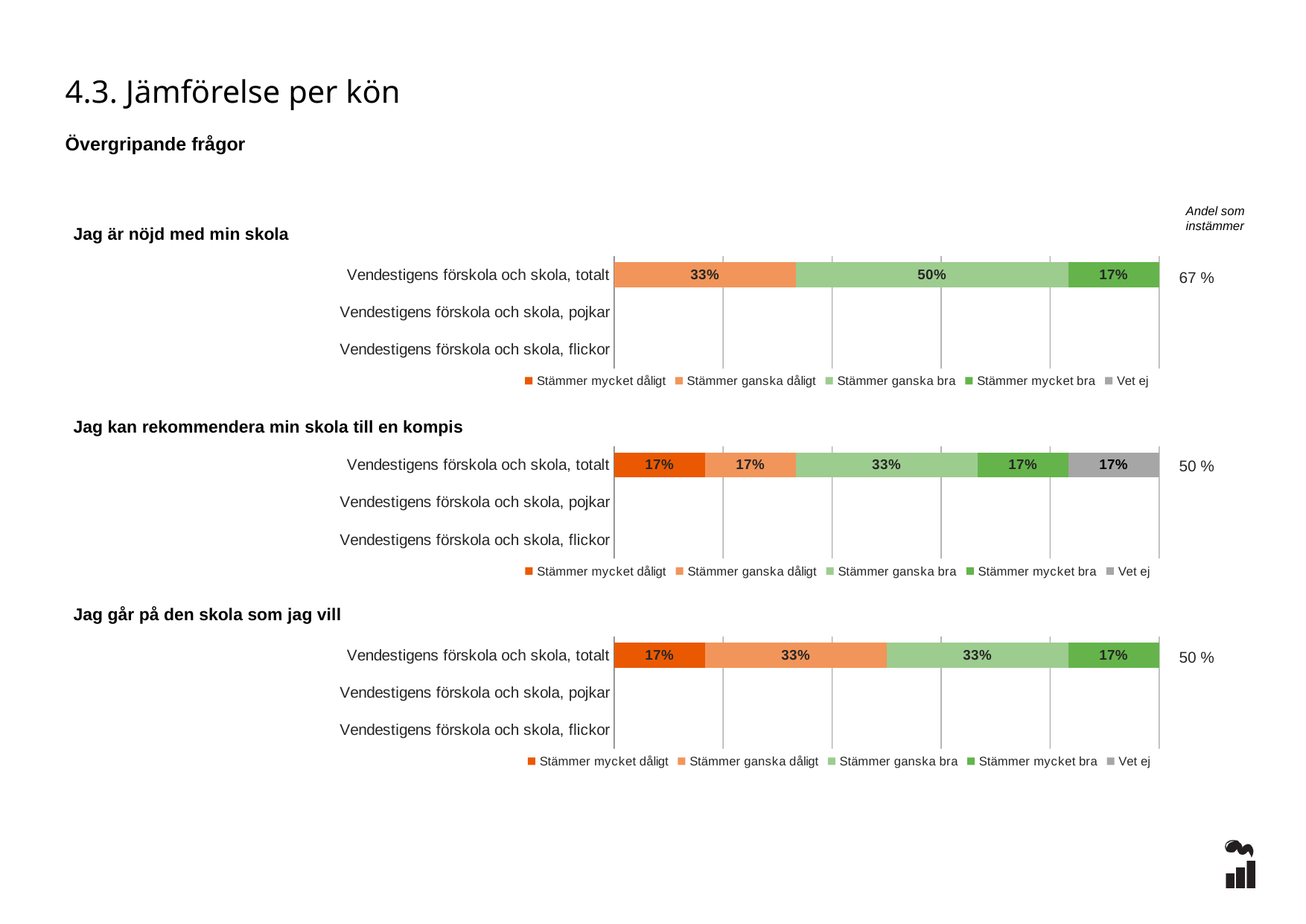
In the chart 'Jag kan rekommendera min skola till en kompis', what is the 'Andel som instämmer' value shown for 'Vendestigens förskola och skola, totalt'? 50 % In the chart 'Jag är nöjd med min skola', what percentage of 'Vendestigens förskola och skola, totalt' answered 'Stämmer ganska bra'? 50% In the chart 'Jag går på den skola som jag vill', what percentage of 'Vendestigens förskola och skola, totalt' answered 'Stämmer mycket dåligt'? 17% What kind of chart is used for 'Jag kan rekommendera min skola till en kompis'? Stacked bar chart How many series does the legend of the chart 'Jag är nöjd med min skola' list? 5 In the chart 'Jag är nöjd med min skola', what is the 'Andel som instämmer' value shown for 'Vendestigens förskola och skola, totalt'? 67 % In the chart 'Jag går på den skola som jag vill', what is the difference between the 'Stämmer ganska dåligt' share and the 'Stämmer mycket bra' share for 'Vendestigens förskola och skola, totalt'? 16% In the chart 'Jag är nöjd med min skola', which response category has the largest share for 'Vendestigens förskola och skola, totalt'? Stämmer ganska bra In the chart 'Jag kan rekommendera min skola till en kompis', what percentage of 'Vendestigens förskola och skola, totalt' answered 'Vet ej'? 17% In the chart 'Jag är nöjd med min skola', what percentage of 'Vendestigens förskola och skola, totalt' answered 'Stämmer ganska dåligt'? 33% In the chart 'Jag kan rekommendera min skola till en kompis', what percentage of 'Vendestigens förskola och skola, totalt' answered 'Stämmer ganska bra'? 33% How many categories are listed on the vertical axis of the chart 'Jag går på den skola som jag vill'? 3